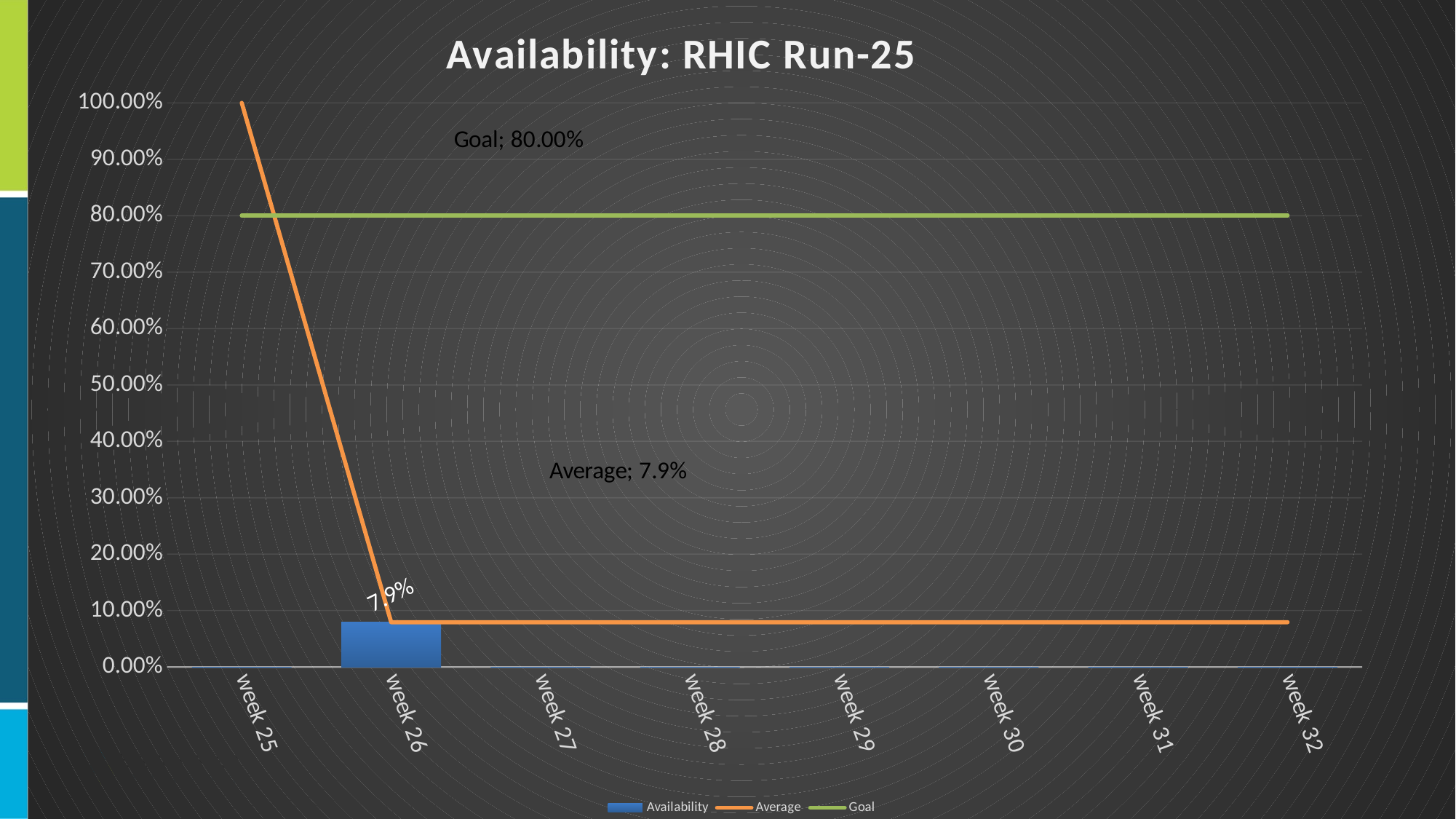
What kind of chart is shown on the slide? bar and line chart What value is labelled for the Goal line? 80.00% At week 30, is the Average line greater or less than 20.00%? less What is the title of the chart? Availability: RHIC Run-25 Does the Average line rise or fall from week 25 to week 26? fall Is the Goal line greater or less than 50.00%? greater What is the Availability value for week 26? 7.9% Which week has the highest Availability bar? week 26 How many series does the legend list? 3 What value is labelled for the Average line? 7.9% What is the difference between the labelled Goal value and the labelled Average value? 72.1% How many weeks are shown on the x axis? 8